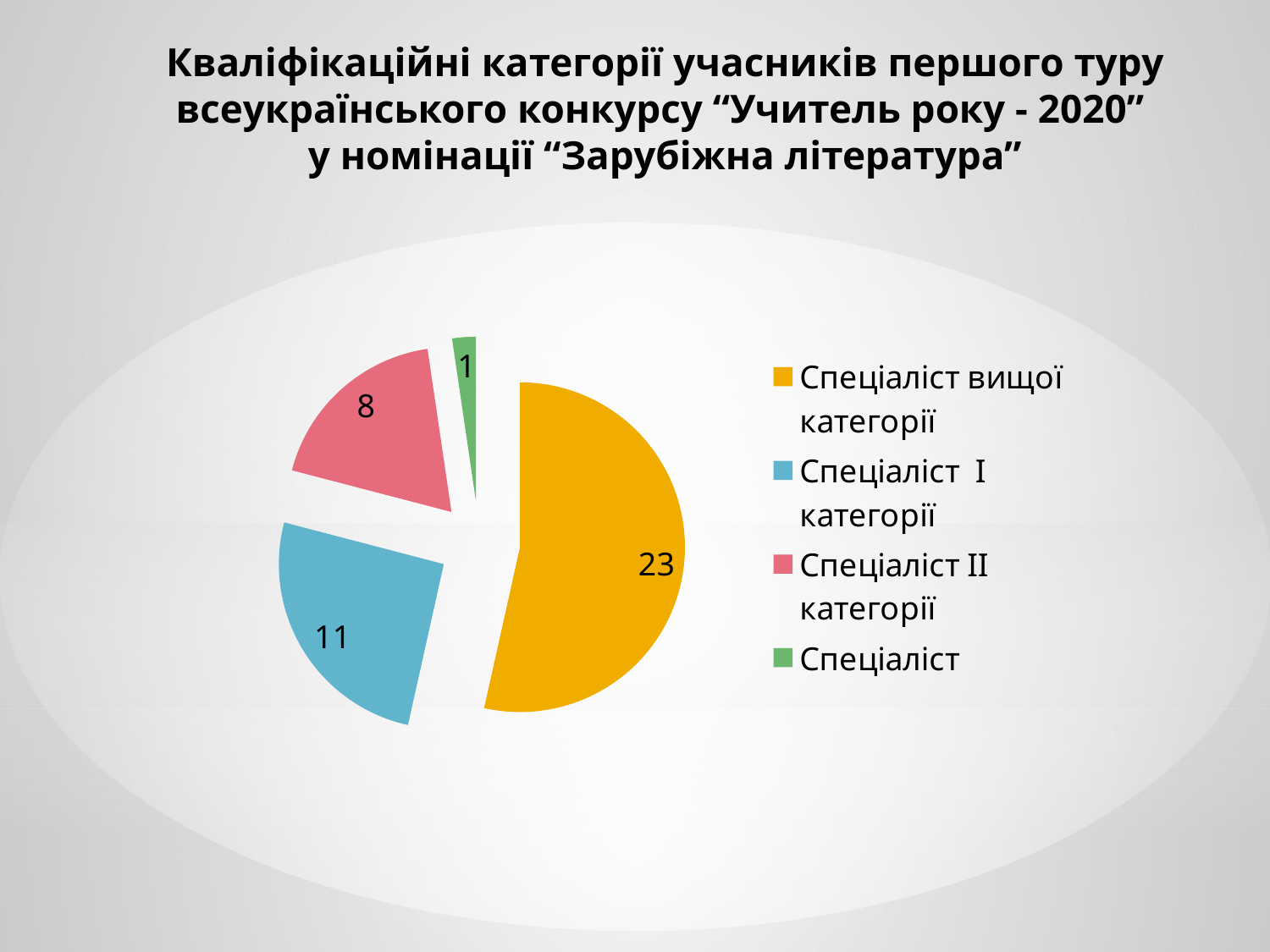
What is the difference between the values for Спеціаліст вищої категорії and Спеціаліст I категорії? 12 How many slices does the pie chart have? 4 What is the value for Спеціаліст II категорії? 8 What is the value for Спеціаліст I категорії? 11 How many entries does the legend list? 4 Which category has the smallest slice? Спеціаліст What colour is the slice for Спеціаліст II категорії? red (pink) Which category has the largest slice? Спеціаліст вищої категорії What is the value for Спеціаліст вищої категорії? 23 Which is larger, the value for Спеціаліст I категорії or Спеціаліст II категорії? Спеціаліст I категорії What type of chart is shown on the slide? pie chart What is the value for Спеціаліст? 1